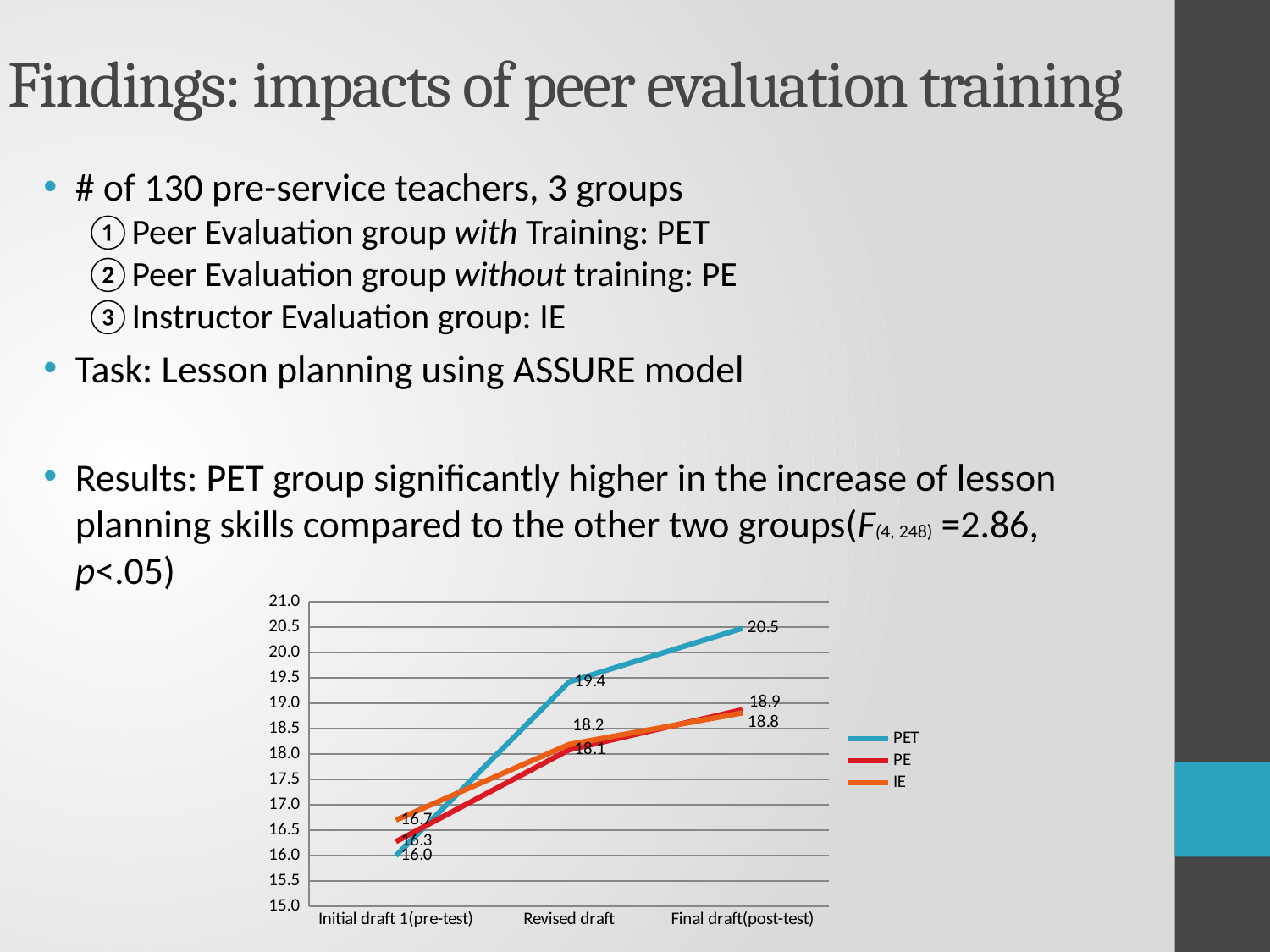
What kind of chart is shown on the slide? line chart What is the value for PET at Revised draft? 19.4 What is the value for PET at Final draft(post-test)? 20.5 Is the value for PET at Final draft(post-test) greater or less than 20.0? greater How many categories are shown on the x axis? 3 What is the value for IE at Initial draft 1(pre-test)? 16.7 Which group has the highest value at Final draft(post-test)? PET How many series does the legend list? 3 What is the value for PET at Initial draft 1(pre-test)? 16.0 At Initial draft 1(pre-test), which is larger, the value for PET or the value for IE? IE What is the difference between the PET value at Final draft(post-test) and at Initial draft 1(pre-test)? 4.5 Which group has the lowest value at Initial draft 1(pre-test)? PET